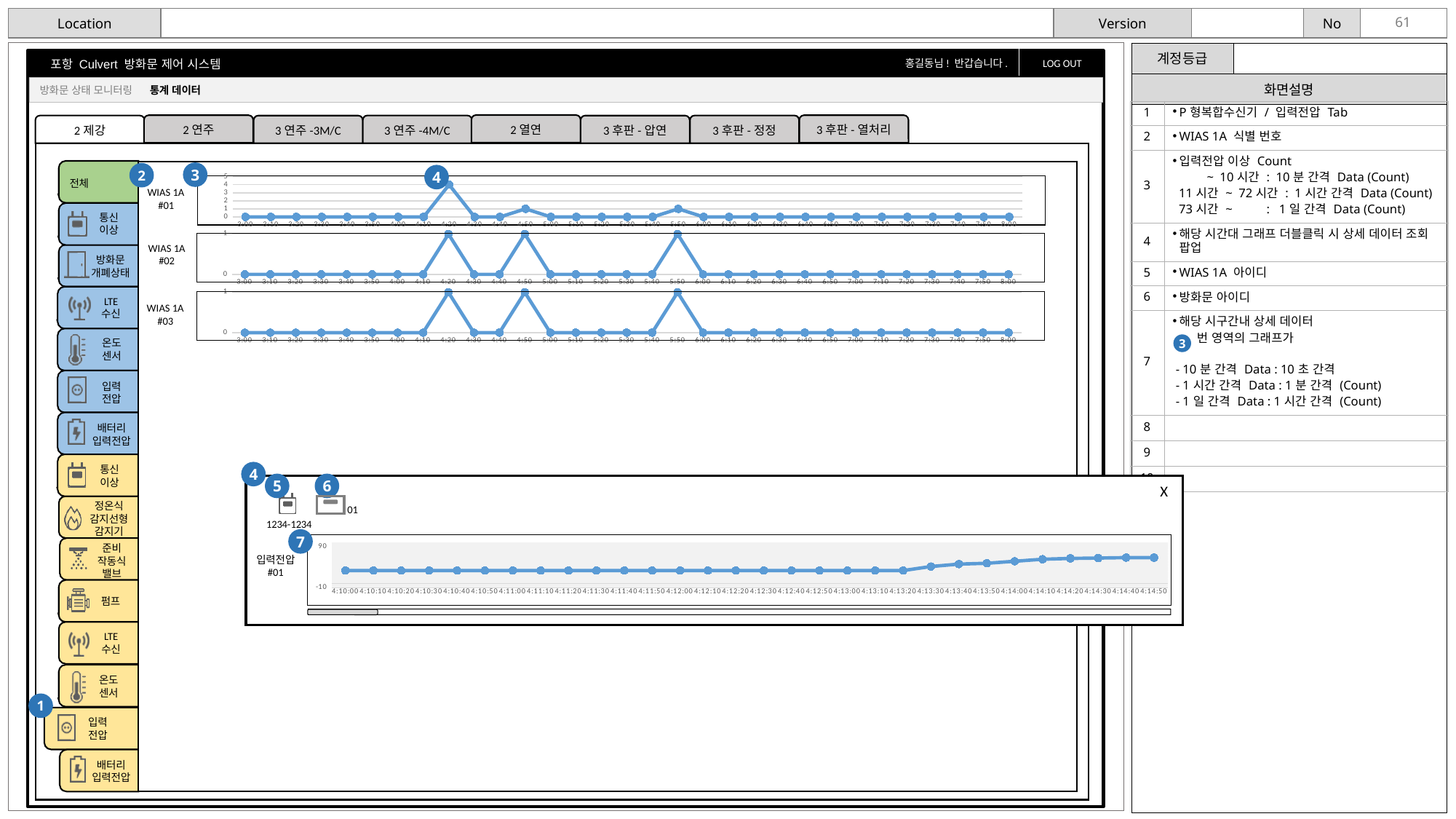
On the 입력전압 #01 chart in the popup, do the values rise or fall toward the right end of the x axis? rise On the WIAS 1A #01 chart, is the value at 4:20 greater or less than 3? greater On the WIAS 1A #02 chart, which is larger, the value at 4:20 or the value at 4:30? 4:20 How many line charts are shown on the slide in total? 4 On the WIAS 1A #03 chart, what is the value at 6:00? 0 On the WIAS 1A #01 chart, is the value at 3:00 greater or less than 1? less On the 입력전압 #01 chart in the popup, what is the highest label on the y axis? 90 On the WIAS 1A #03 chart, what is the value at 5:50? 1 What kind of chart is the WIAS 1A #02 chart? line chart On the WIAS 1A #01 chart, at which time is the value highest? 4:20 On the WIAS 1A #02 chart, what is the value at 3:00? 0 On the WIAS 1A #02 chart, what is the value at 4:20? 1